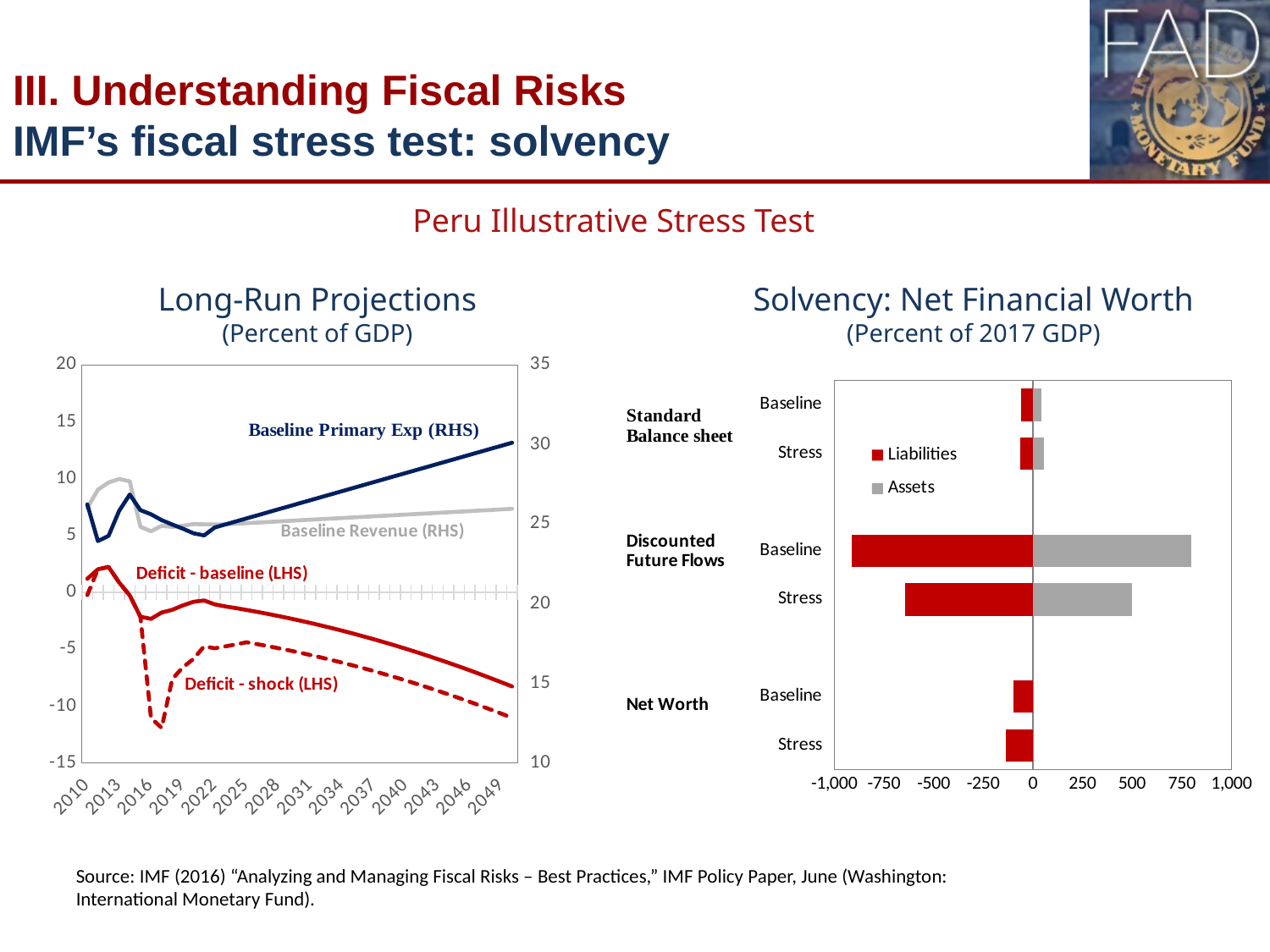
In the 'Solvency: Net Financial Worth' chart, is the Assets value for Discounted Future Flows Baseline greater or less than 500? greater In the 'Solvency: Net Financial Worth' chart, which has the larger Assets bar for Discounted Future Flows: Baseline or Stress? Baseline In the 'Long-Run Projections' chart, does the 'Baseline Primary Exp (RHS)' line rise or fall from 2022 to 2049? rise In the 'Solvency: Net Financial Worth' chart, what are the two series named in the legend? Liabilities and Assets In the 'Long-Run Projections' chart, which line is drawn dashed? Deficit - shock (LHS) What kind of chart is the 'Long-Run Projections' chart on the left? line chart In the 'Solvency: Net Financial Worth' chart, how many series does the legend list? 2 In the 'Solvency: Net Financial Worth' chart, is the Liabilities value for Discounted Future Flows Baseline greater or less than -750? less What kind of chart is the 'Solvency: Net Financial Worth' chart on the right? bar chart In the 'Solvency: Net Financial Worth' chart, is the Liabilities value for Discounted Future Flows Stress greater or less than -500? less In the 'Solvency: Net Financial Worth' chart, which Net Worth bar is more negative: Baseline or Stress? Stress In the 'Long-Run Projections' chart, how many lines are labelled? 4